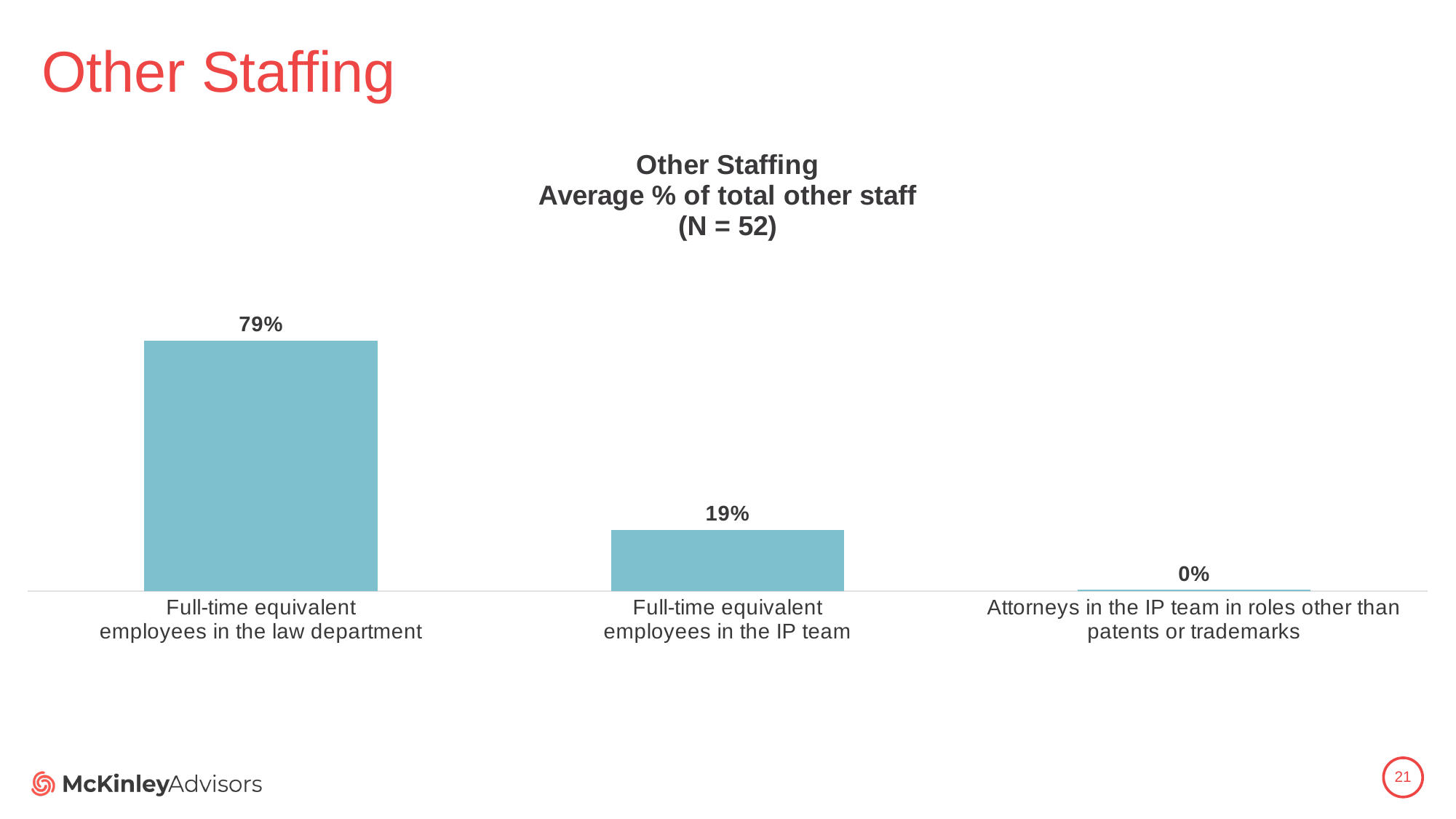
What is the average % of total other staff for attorneys in the IP team in roles other than patents or trademarks? 0% Which category has the highest average % of total other staff? Full-time equivalent employees in the law department What is the sample size (N) stated in the chart title? 52 Which category has the lowest average % of total other staff? Attorneys in the IP team in roles other than patents or trademarks Do the values rise or fall from left to right across the categories? Fall What is the average % of total other staff for full-time equivalent employees in the law department? 79% How many categories are shown in the chart? 3 Which is larger: the value for full-time equivalent employees in the IP team or the value for attorneys in the IP team in roles other than patents or trademarks? Full-time equivalent employees in the IP team What is the title of the chart? Other Staffing Average % of total other staff (N = 52) What is the average % of total other staff for full-time equivalent employees in the IP team? 19% What kind of chart is shown on the slide? Bar chart What is the difference in percentage points between full-time equivalent employees in the law department and full-time equivalent employees in the IP team? 60 percentage points